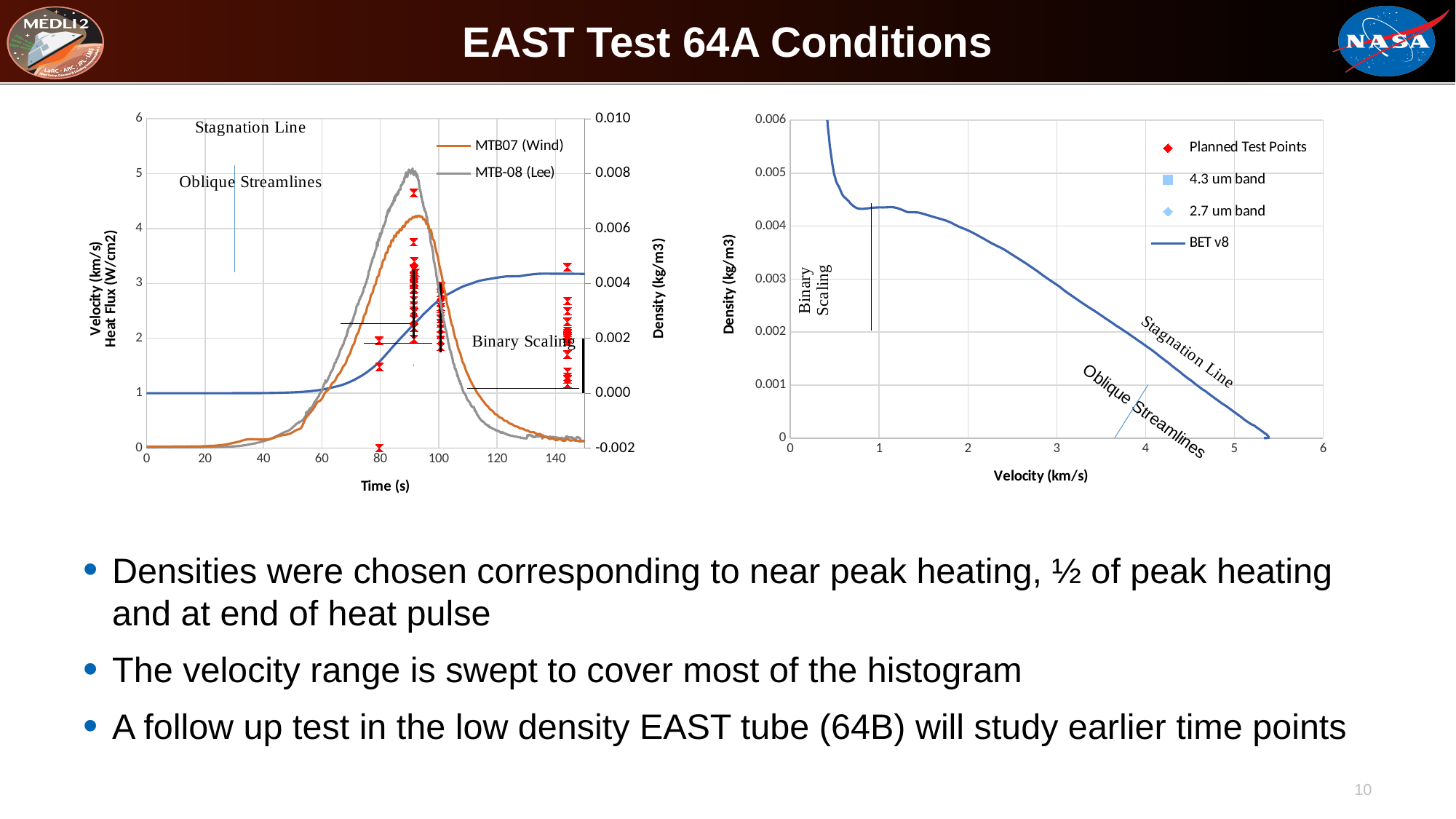
In the right chart, is the BET v8 density at a velocity of 2 km/s greater or less than 0.003? greater In the left chart, is the peak value of MTB07 (Wind) greater or less than 4? greater In the right chart, is the BET v8 density at a velocity of 5 km/s greater or less than 0.001? less What is the x-axis title of the right chart? Velocity (km/s) What kind of chart is the right chart on the slide? line chart In the left chart, which series reaches a higher peak heat flux, MTB07 (Wind) or MTB-08 (Lee)? MTB-08 (Lee) What kind of chart is the left chart on the slide? line chart In the left chart, does the MTB07 (Wind) heat flux rise or fall between 100 s and 140 s? fall What is the x-axis title of the left chart? Time (s) How many series does the legend of the left chart list? 2 In the right chart, does the BET v8 density rise or fall as velocity increases from 1 to 5 km/s? fall How many entries does the legend of the right chart list? 4